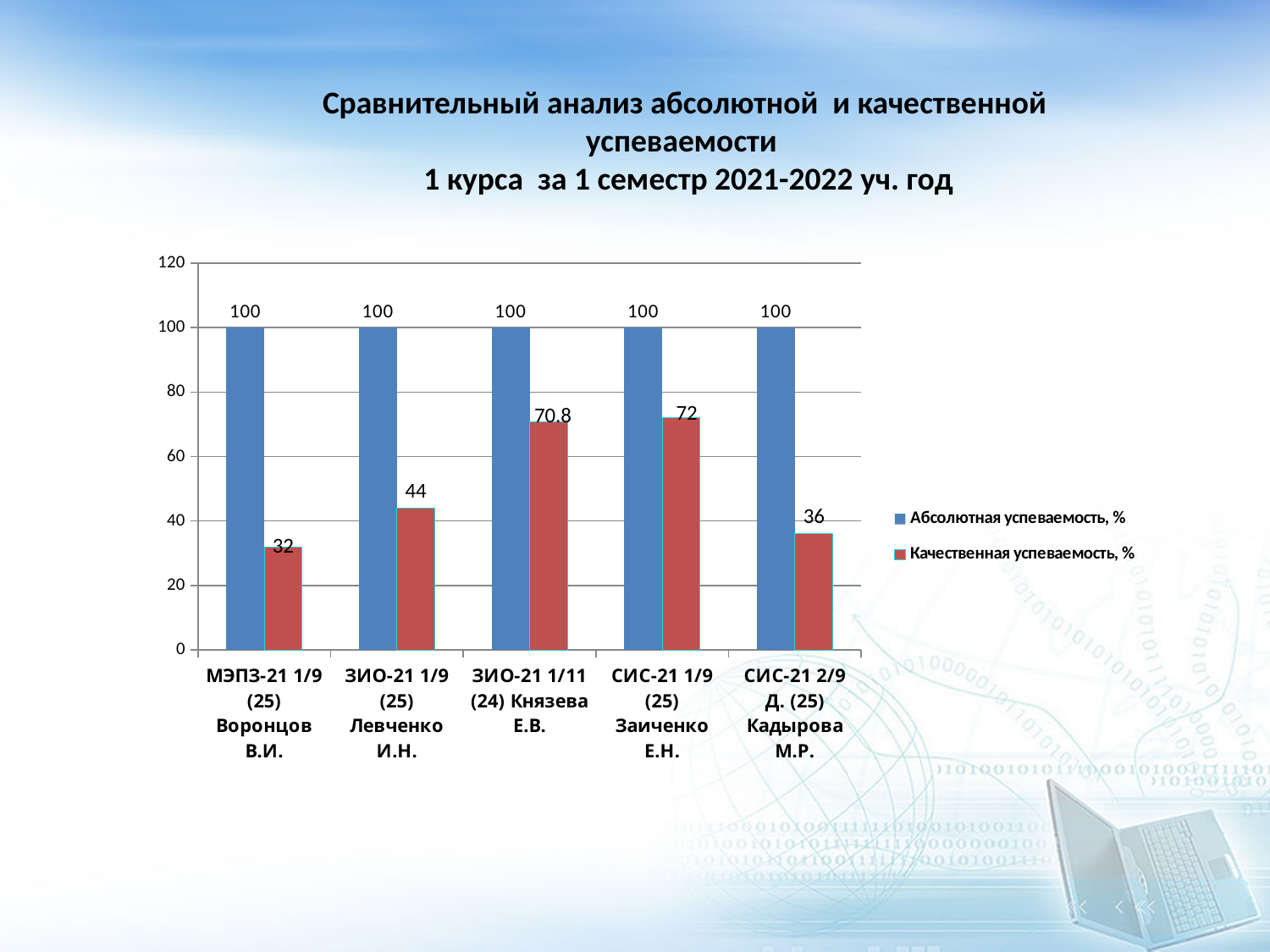
What is the Качественная успеваемость, % value for МЭПЗ-21 1/9 (25) Воронцов В.И.? 32 What is the Абсолютная успеваемость, % value for СИС-21 1/9 (25) Заиченко Е.Н.? 100 How many groups are shown on the x axis? 5 Which colour represents Абсолютная успеваемость, % in the legend? blue How many series does the legend list? 2 Which is larger: the Качественная успеваемость, % for ЗИО-21 1/9 (25) Левченко И.Н. or for СИС-21 2/9 Д. (25) Кадырова М.Р.? ЗИО-21 1/9 (25) Левченко И.Н. What is the difference between the Качественная успеваемость, % values for ЗИО-21 1/9 (25) Левченко И.Н. and СИС-21 2/9 Д. (25) Кадырова М.Р.? 8 Which group has the highest Качественная успеваемость, %? СИС-21 1/9 (25) Заиченко Е.Н. What is the Качественная успеваемость, % value for ЗИО-21 1/11 (24) Князева Е.В.? 70.8 What kind of chart is shown on the slide? bar chart Which group has the lowest Качественная успеваемость, %? МЭПЗ-21 1/9 (25) Воронцов В.И. Is the Качественная успеваемость, % value for СИС-21 1/9 (25) Заиченко Е.Н. greater or less than 60? greater